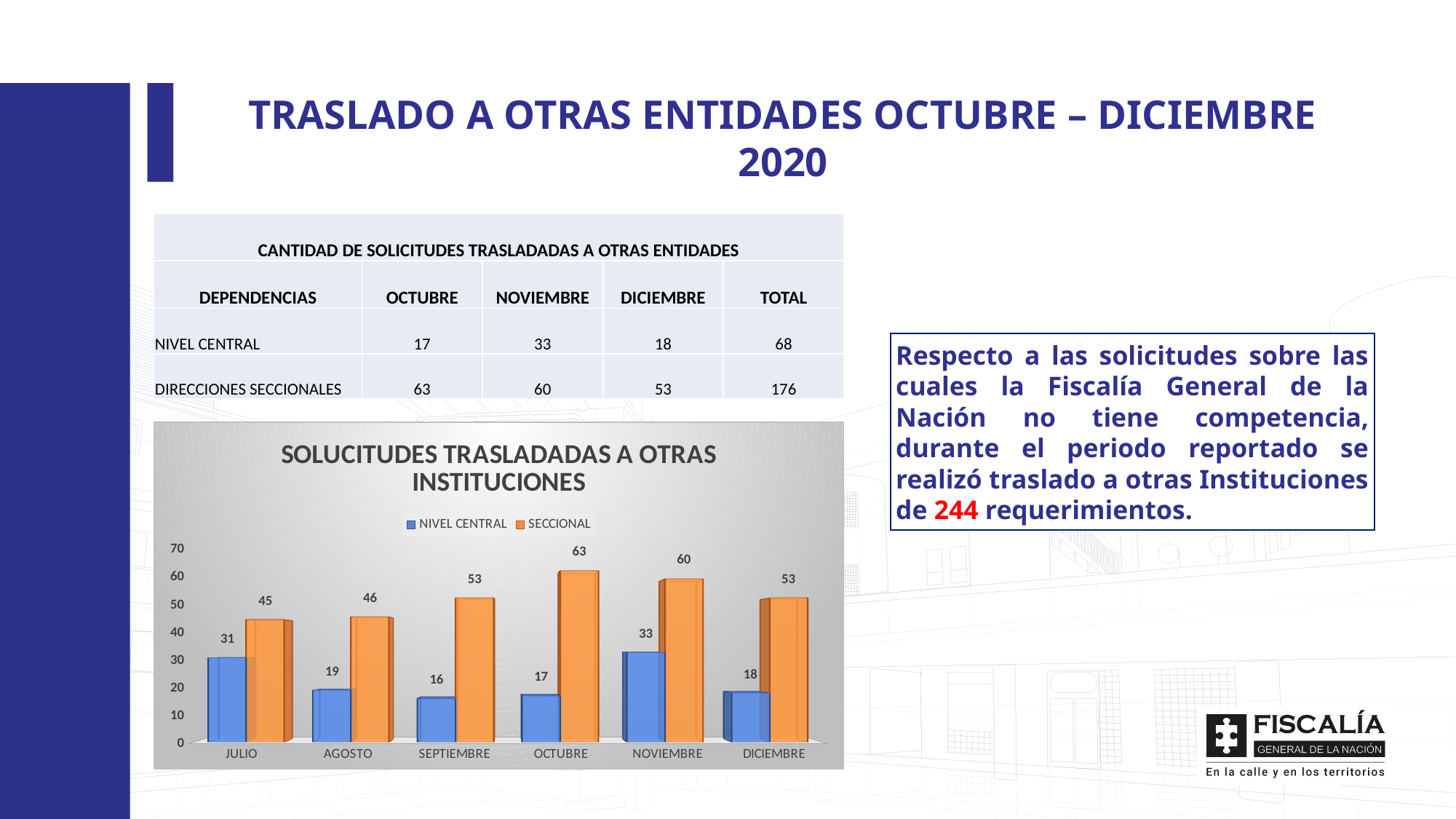
In which month is the NIVEL CENTRAL value lowest? SEPTIEMBRE How many months are shown on the x axis of the chart? 6 What is the value for NIVEL CENTRAL in OCTUBRE? 17 What is the title of the chart? SOLUCITUDES TRASLADADAS A OTRAS INSTITUCIONES Which is larger: NIVEL CENTRAL in JULIO or NIVEL CENTRAL in AGOSTO? NIVEL CENTRAL in JULIO In which month is the SECCIONAL value highest? OCTUBRE How many series does the chart legend list? 2 Does the NIVEL CENTRAL value rise or fall from JULIO to SEPTIEMBRE? Fall What is the difference between the SECCIONAL and NIVEL CENTRAL values in OCTUBRE? 46 What kind of chart is shown on the slide? Bar chart What is the value for SECCIONAL in NOVIEMBRE? 60 What is the value for SECCIONAL in JULIO? 45